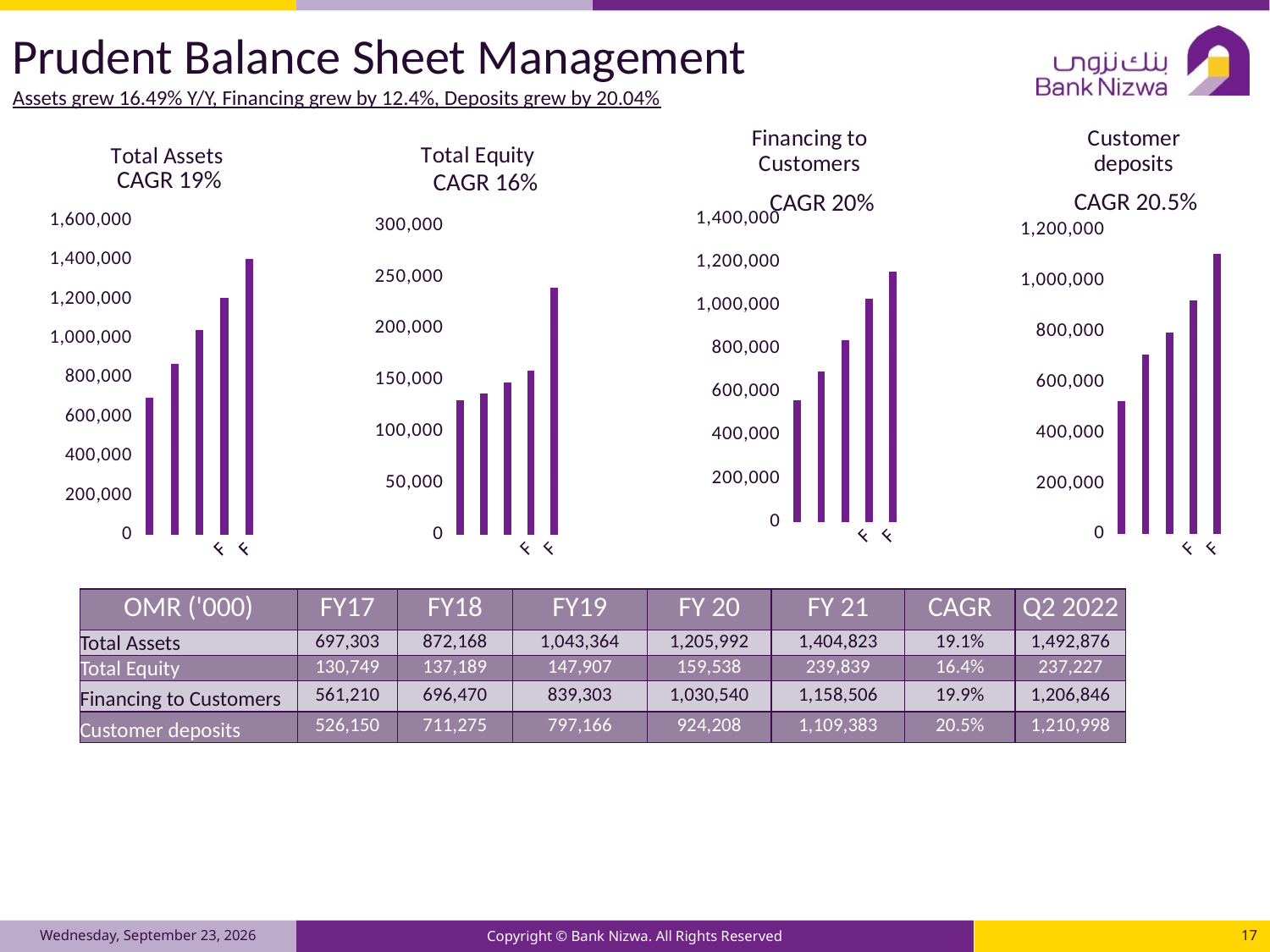
In the Customer deposits chart, which bar is the tallest? the rightmost (last) bar In the Total Equity chart, is the value of the rightmost bar greater or less than 200,000? greater In the Total Assets chart, which bar is the shortest? the leftmost (first) bar In the Total Equity chart, is the rightmost bar taller or shorter than the leftmost bar? taller In the Customer deposits chart, is the value of the leftmost bar greater or less than 400,000? greater In the Total Assets chart, is the value of the rightmost bar greater or less than 1,200,000? greater What kind of chart is the Total Assets chart? bar chart In the Financing to Customers chart, do the values rise or fall from left to right? rise What CAGR is stated in the title of the Total Assets chart? 19% How many bars are plotted in the Total Equity chart? 5 What CAGR is stated in the title of the Customer deposits chart? 20.5%